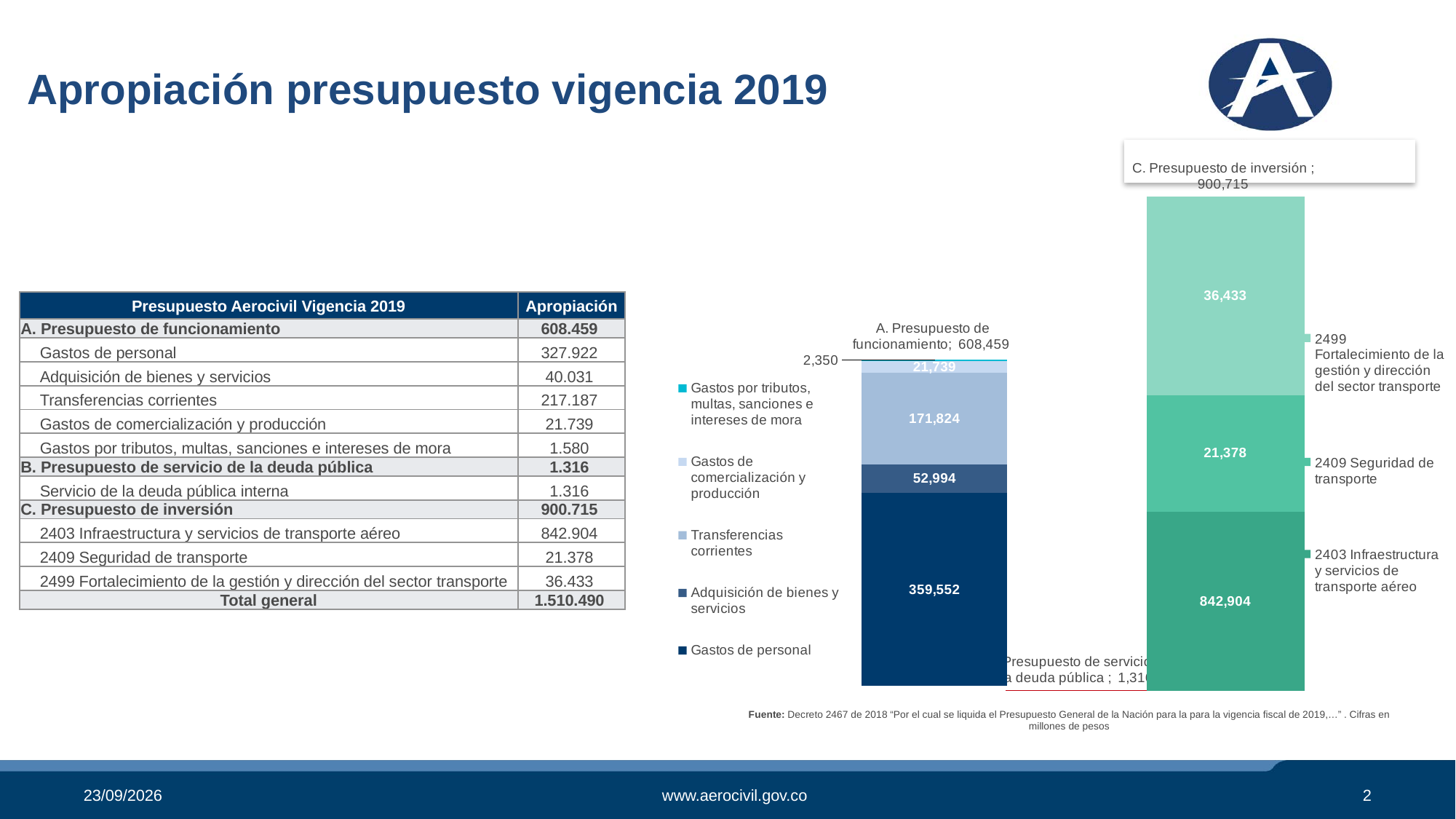
In the chart, what is the value labelled for 2499 Fortalecimiento de la gestión y dirección del sector transporte? 36,433 In the chart, what is the value labelled for 2403 Infraestructura y servicios de transporte aéreo? 842,904 In the chart, what total is labelled for the C. Presupuesto de inversión bar? 900,715 In the chart, what is the value labelled for Transferencias corrientes? 171,824 In the chart, what is the value labelled for Gastos por tributos, multas, sanciones e intereses de mora? 2,350 In the chart, which is larger: Transferencias corrientes or Adquisición de bienes y servicios? Transferencias corrientes What kind of chart is shown on the right side of the slide? Stacked bar chart In the chart, what is the difference between the values for 2403 Infraestructura y servicios de transporte aéreo and 2499 Fortalecimiento de la gestión y dirección del sector transporte? 806,471 In the chart, which segment of the C. Presupuesto de inversión bar is the largest? 2403 Infraestructura y servicios de transporte aéreo In the chart, what is the value labelled for Gastos de personal? 359,552 In the chart, what total is labelled for the A. Presupuesto de funcionamiento bar? 608,459 In the chart, which segment of the A. Presupuesto de funcionamiento bar is the smallest? Gastos por tributos, multas, sanciones e intereses de mora